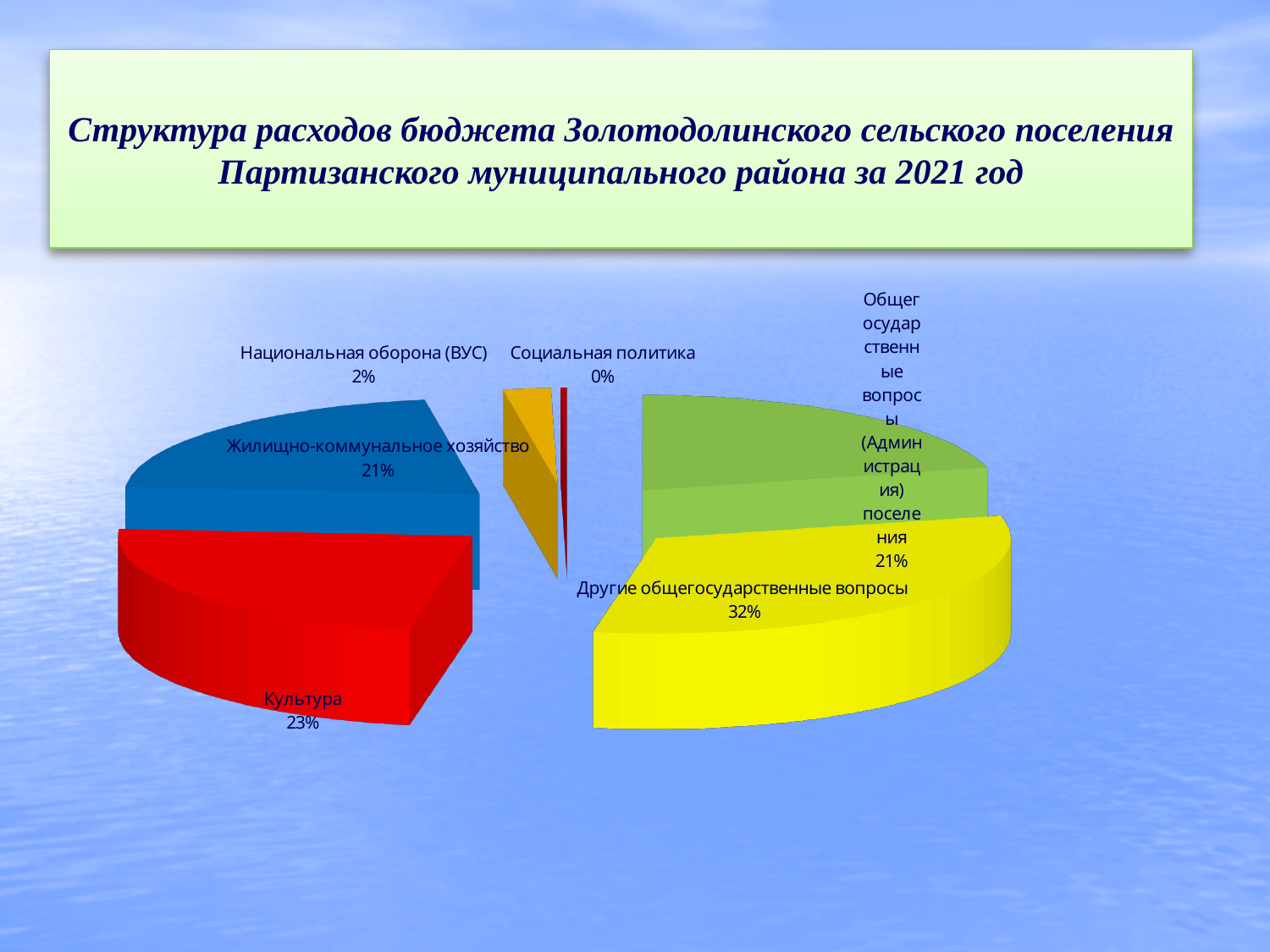
What colour is the slice for Культура? red What share of the budget expenditure goes to Культура? 23% What share is shown for Социальная политика? 0% What share is shown for Жилищно-коммунальное хозяйство? 21% How many categories (slices) does the pie chart have? 6 Which is larger, the share for Культура or the share for Жилищно-коммунальное хозяйство? Культура What share is shown for Национальная оборона (ВУС)? 2% What is the difference in percentage points between Другие общегосударственные вопросы and Культура? 9 What kind of chart is shown on the slide? pie chart Which category has the largest share of the pie? Другие общегосударственные вопросы Which category has the smallest share of the pie? Социальная политика What share is shown for Другие общегосударственные вопросы? 32%